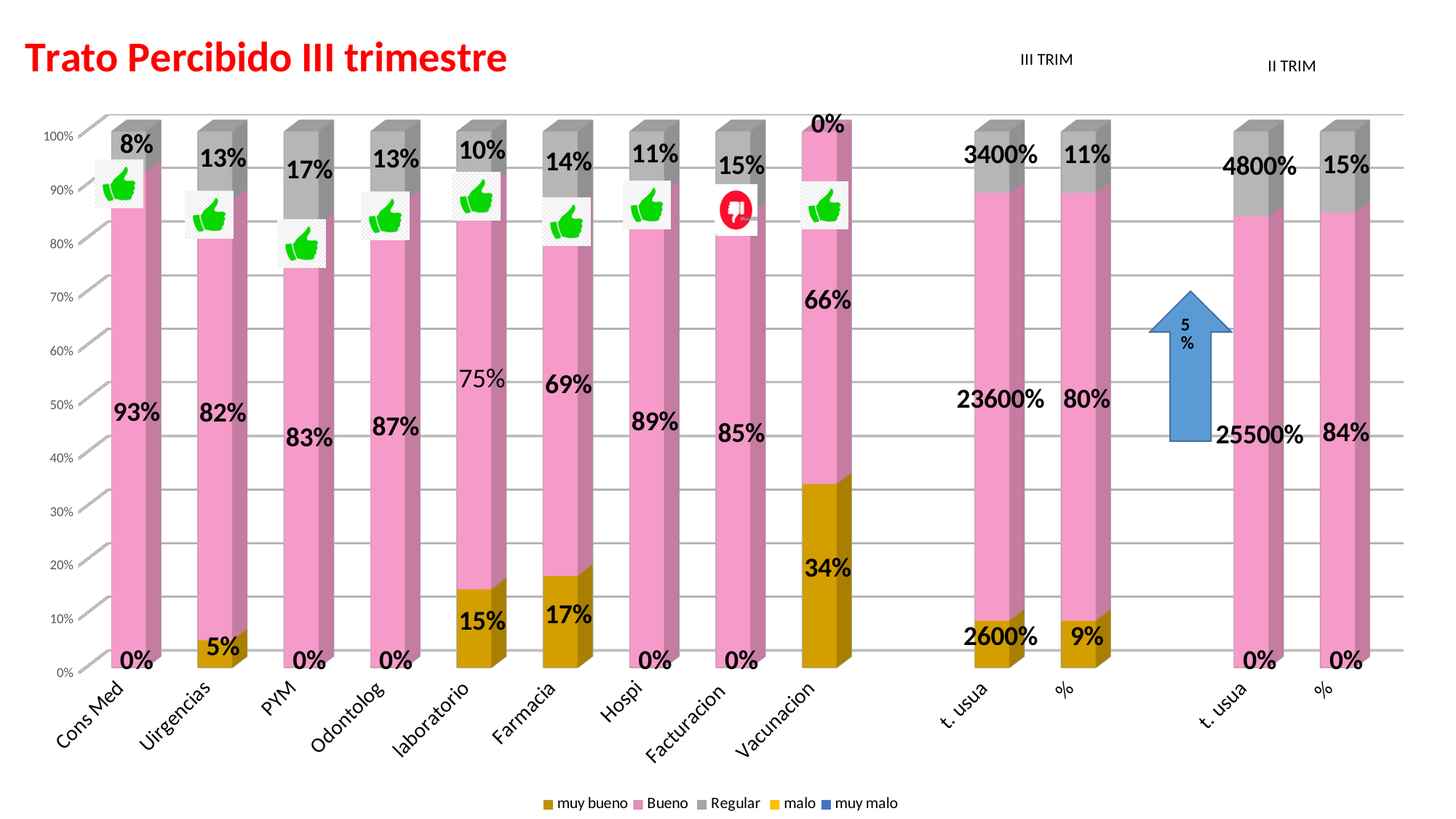
What is the muy bueno value for Farmacia? 17% How many series does the legend list? 5 What is the Regular value for PYM? 17% What is the difference between the Bueno values for Hospi and Facturacion? 4% What is the title of the slide? Trato Percibido III trimestre Which is larger, the Regular value for Uirgencias or the Regular value for Hospi? Uirgencias What is the Bueno value for laboratorio? 75% What kind of chart is shown on the slide? Stacked bar chart Among the service categories from Cons Med to Vacunacion, which has the highest Bueno value? Cons Med What is the Bueno value for Cons Med? 93% Among the service categories from Cons Med to Vacunacion, which has the lowest Bueno value? Vacunacion What is the muy bueno value for Vacunacion? 34%